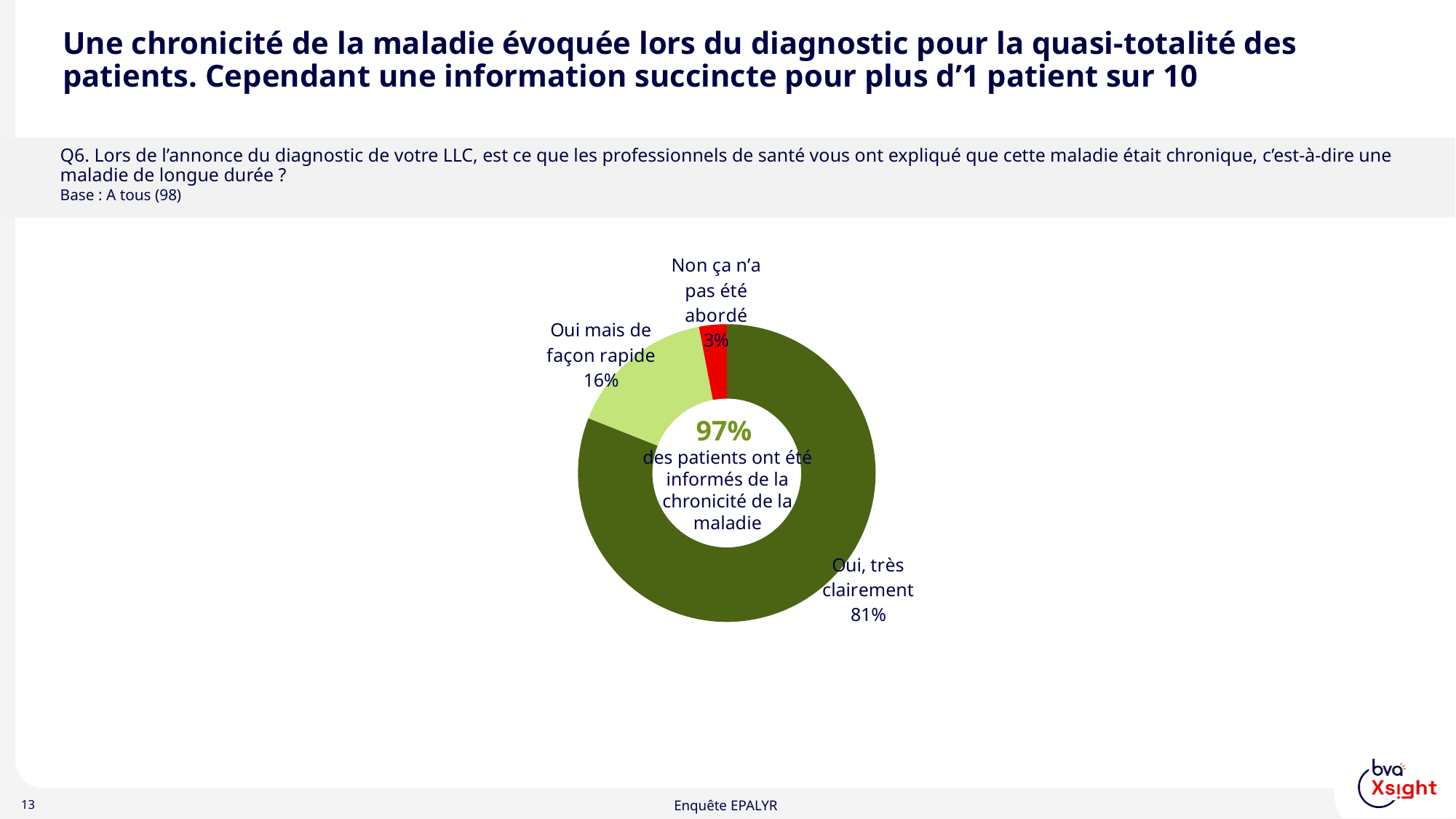
What kind of chart is shown on the slide? Doughnut (pie) chart What percentage of patients answered "Oui, très clairement"? 81% What is the difference in percentage points between "Oui, très clairement" and "Oui mais de façon rapide"? 65 Which is larger: the share for "Oui mais de façon rapide" or the share for "Non ça n'a pas été abordé"? Oui mais de façon rapide What colour is the slice for "Non ça n'a pas été abordé"? Red What is the combined share of the two "Oui" categories? 97% What percentage of patients answered "Oui mais de façon rapide"? 16% What percentage of patients answered "Non ça n'a pas été abordé"? 3% How many response categories are shown in the chart? 3 Which response category has the largest share of the chart? Oui, très clairement What percentage is displayed in the centre of the doughnut chart? 97% Which response category has the smallest share of the chart? Non ça n'a pas été abordé